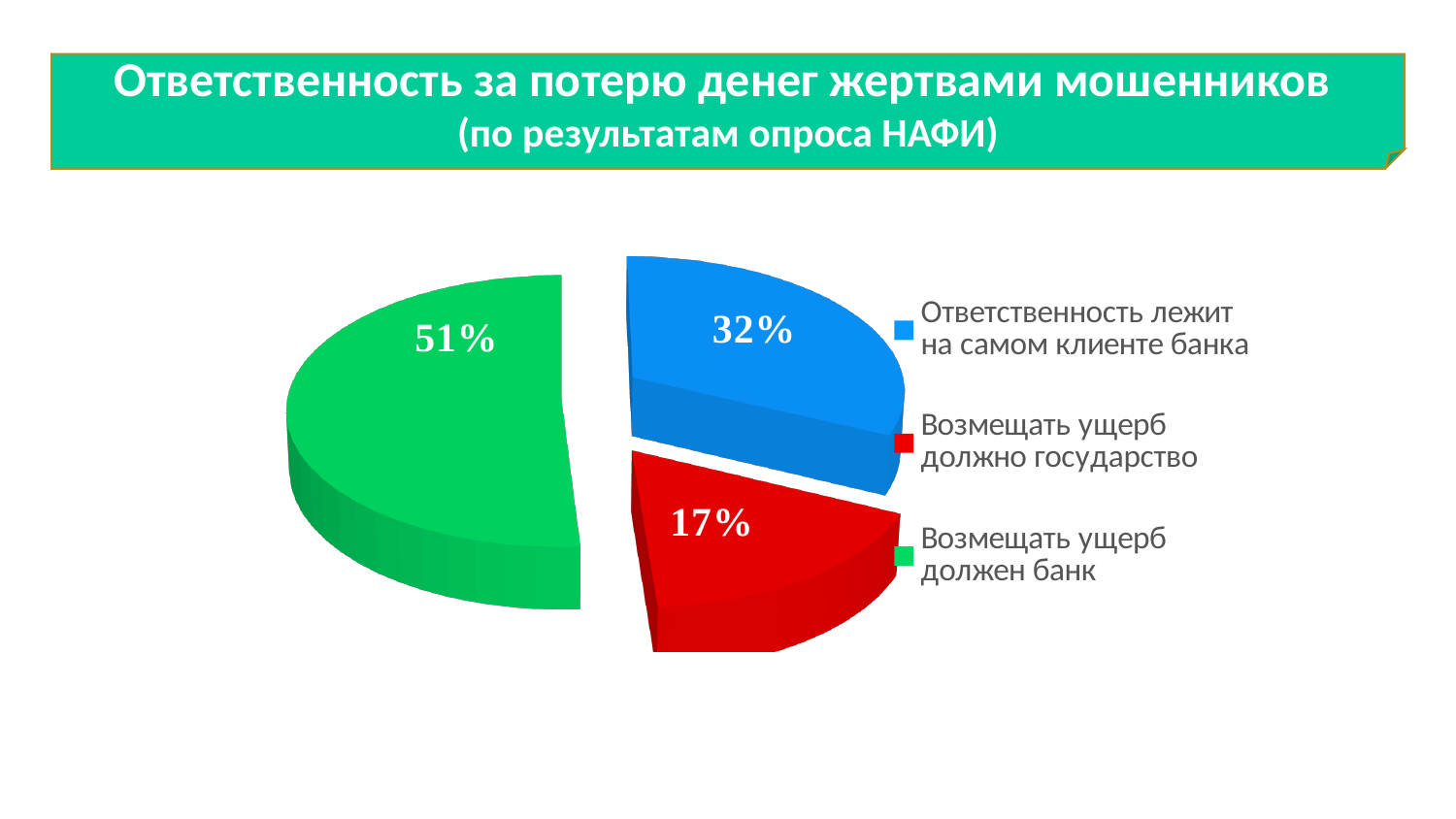
What is the title of the slide containing the chart? Ответственность за потерю денег жертвами мошенников (по результатам опроса НАФИ) What colour is the slice for 'Возмещать ущерб должно государство'? red What share of respondents said the bank should compensate the damage (Возмещать ущерб должен банк)? 51% How many slices does the pie chart have? 3 Which answer option has the smallest share in the pie chart? Возмещать ущерб должно государство What is the difference in percentage points between the 'bank should compensate' slice and the 'client is responsible' slice? 19 What share of respondents said the state should compensate the damage (Возмещать ущерб должно государство)? 17% What share of respondents said responsibility lies with the bank client (Ответственность лежит на самом клиенте банка)? 32% What is the difference in percentage points between the 'client is responsible' slice and the 'state should compensate' slice? 15 What kind of chart is shown on the slide? pie chart Which answer option has the largest share in the pie chart? Возмещать ущерб должен банк Which is larger: the share for 'Ответственность лежит на самом клиенте банка' or for 'Возмещать ущерб должно государство'? Ответственность лежит на самом клиенте банка